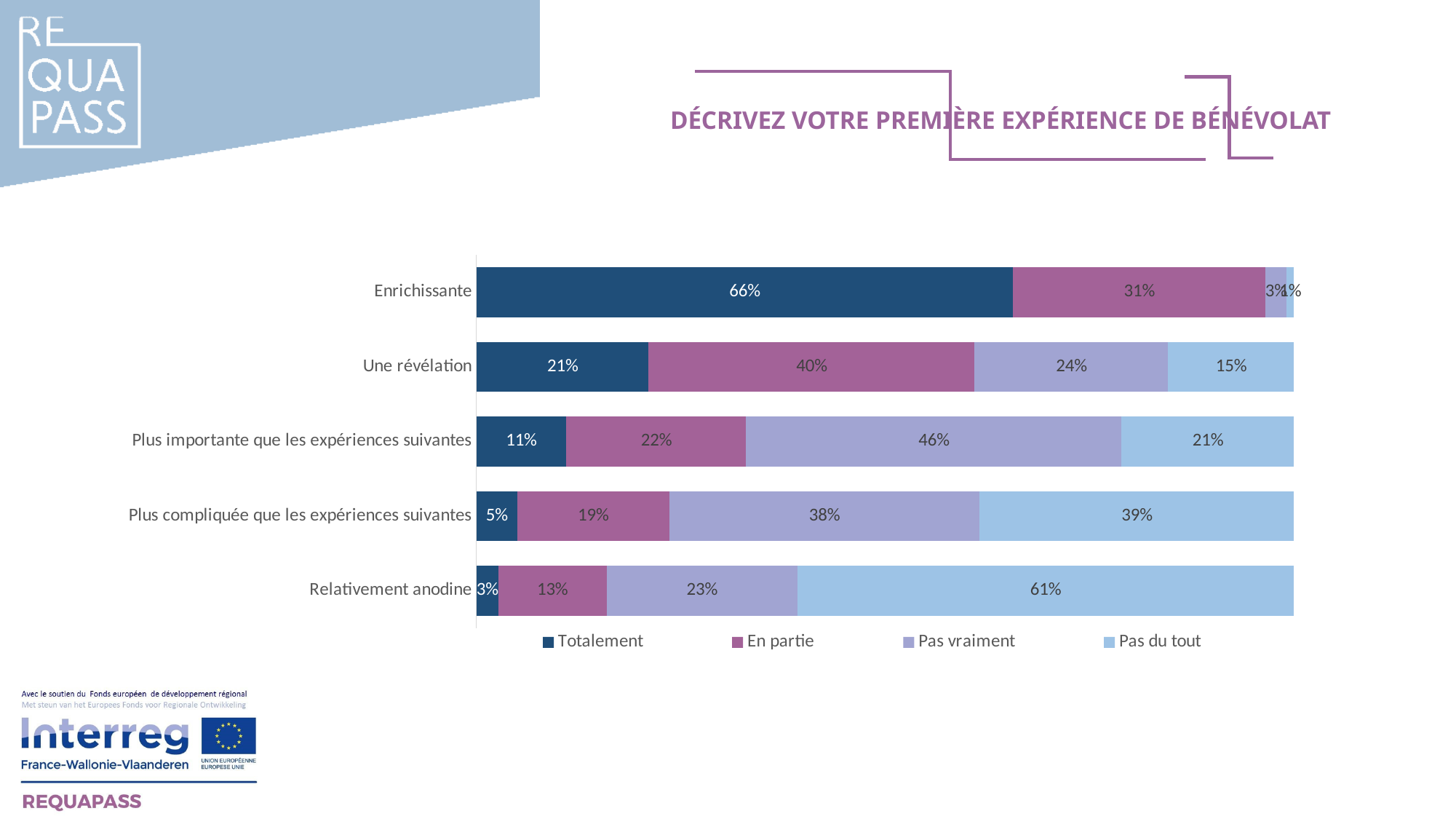
What is the title of the chart? DÉCRIVEZ VOTRE PREMIÈRE EXPÉRIENCE DE BÉNÉVOLAT Which category has the highest 'Totalement' value? Enrichissante Which category has the lowest 'Totalement' value? Relativement anodine Which is larger: the 'En partie' value for 'Plus importante que les expériences suivantes' or for 'Plus compliquée que les expériences suivantes'? Plus importante que les expériences suivantes What is the 'Totalement' value for 'Enrichissante'? 66% What is the difference between the 'Pas du tout' values for 'Plus compliquée que les expériences suivantes' and 'Une révélation'? 24% What type of chart is shown on the slide? Stacked bar chart What is the 'Pas du tout' value for 'Relativement anodine'? 61% What is the 'En partie' value for 'Une révélation'? 40% How many categories are shown on the chart? 5 How many series does the legend list? 4 What is the 'Pas vraiment' value for 'Plus importante que les expériences suivantes'? 46%